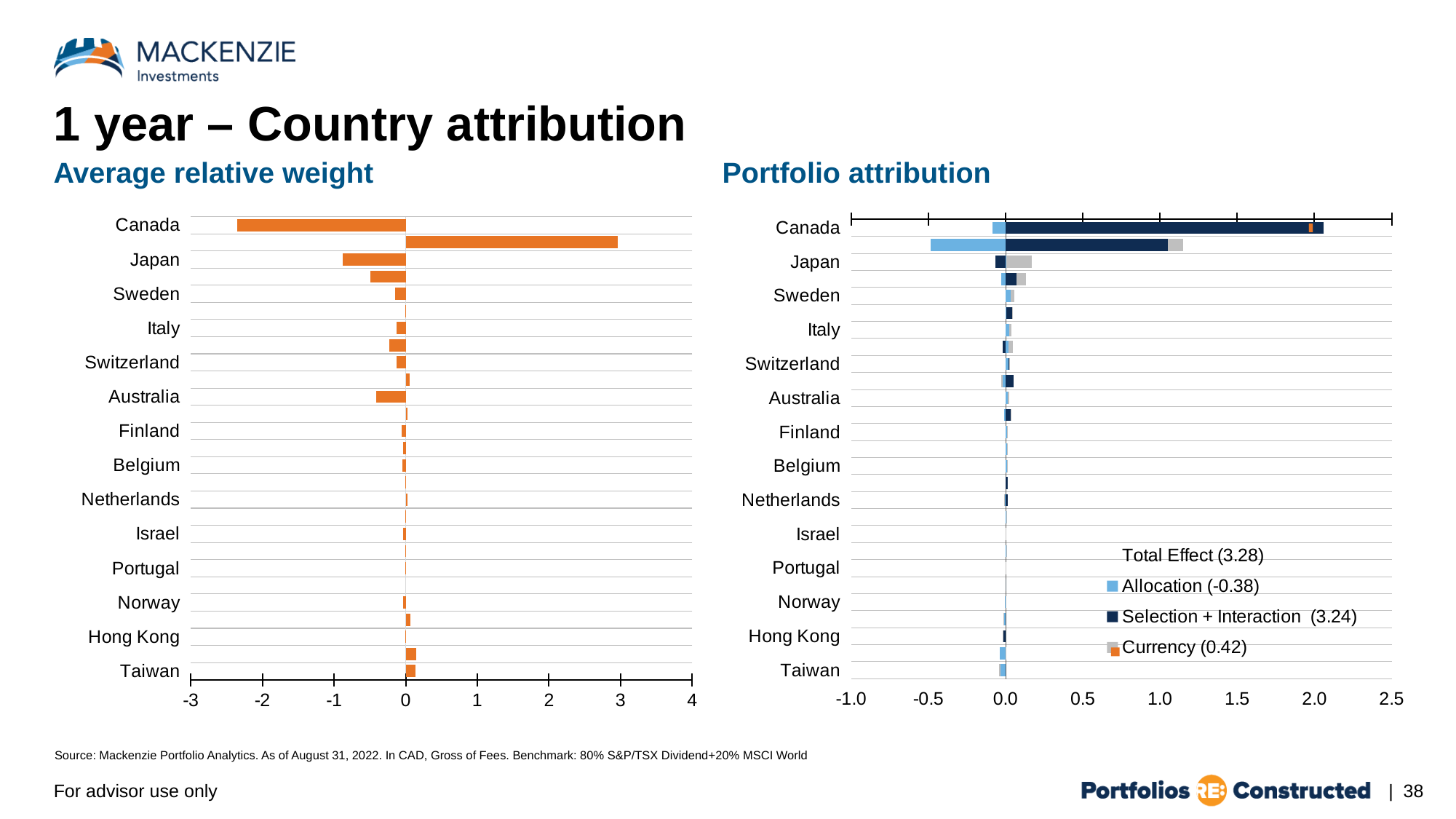
In the 'Average relative weight' chart, is the value for Australia greater or less than -1? greater In the 'Portfolio attribution' chart, what value is shown in the legend for Allocation? -0.38 In the 'Average relative weight' chart, which labelled country has the lowest (most negative) relative weight? Canada In the 'Portfolio attribution' chart, how many entries does the legend list? 4 In the 'Portfolio attribution' chart, is the Allocation value for Canada greater or less than 0.0? less What kind of chart is the 'Portfolio attribution' chart on the right? bar chart In the 'Average relative weight' chart, is the value for Canada greater or less than -2? less In the 'Portfolio attribution' chart, what value is shown in the legend for Total Effect? 3.28 In the 'Average relative weight' chart, which has the lower relative weight, Canada or Japan? Canada What kind of chart is the 'Average relative weight' chart on the left? bar chart